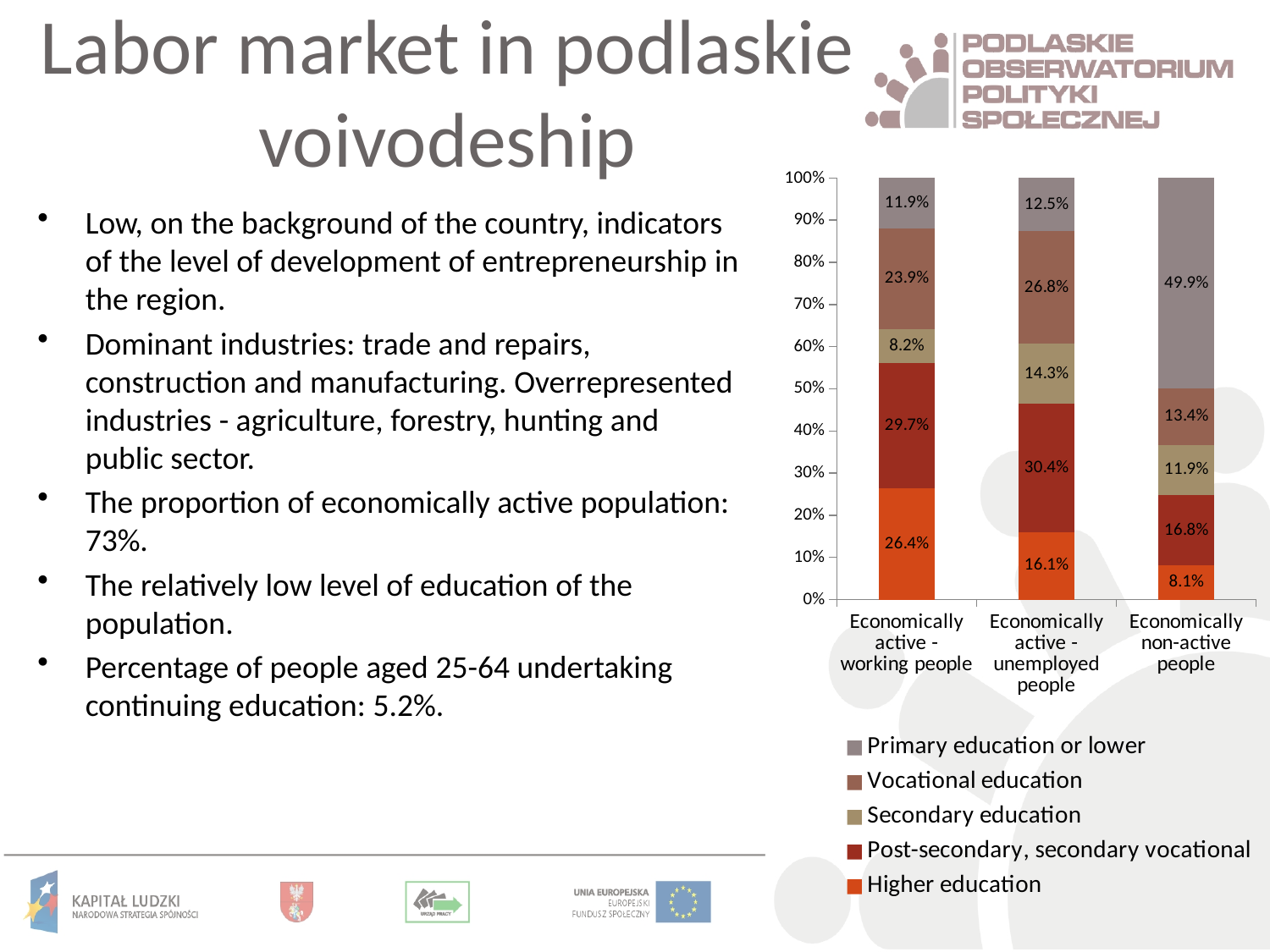
Which legend entry is shown in orange? Higher education Which category has the lowest share of primary education or lower? Economically active - working people What is the share of primary education or lower among economically non-active people? 49.9% What percentage of economically active working people have higher education? 26.4% What percentage of economically active unemployed people have secondary education? 14.3% What kind of chart is shown on the slide? Stacked bar chart What is the vocational education share for economically active working people? 23.9% How many categories are shown on the x axis? 3 What is the difference between the higher education share of economically active working people and economically non-active people? 18.3% How many series does the legend list? 5 Which is larger: the post-secondary, secondary vocational share for unemployed people or for working people? Unemployed people Which category has the highest share of higher education? Economically active - working people